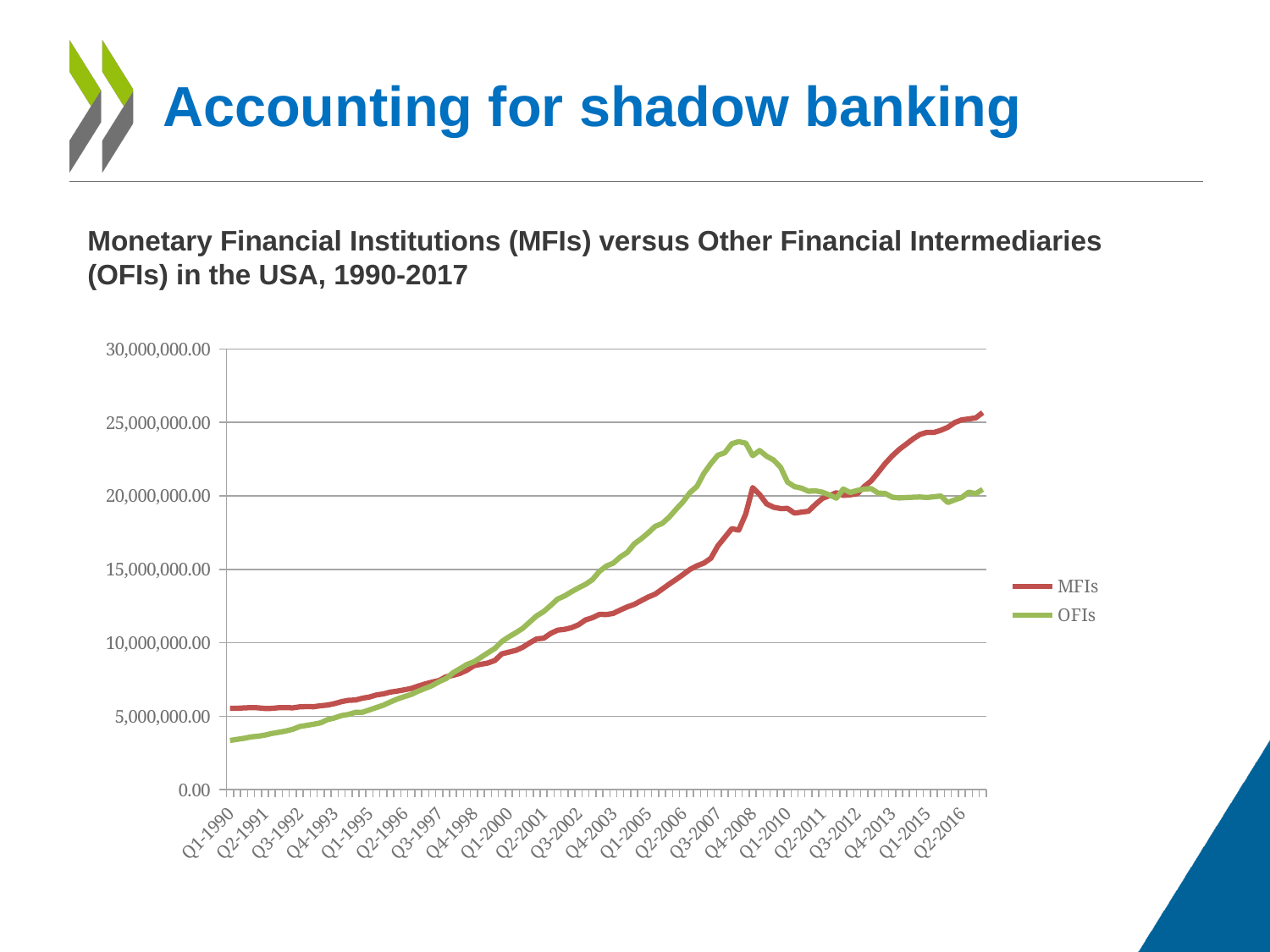
How many series does the legend list? 2 What are the two series named in the legend? MFIs and OFIs Around Q4-2008, which series has the higher value, MFIs or OFIs? OFIs Is the value for MFIs at Q3-2007 greater or less than 20,000,000.00? less Is the value for MFIs at Q1-1990 greater or less than 10,000,000.00? less Which colour is used for the OFIs line? Green Does the MFIs line overall rise or fall from Q1-1990 to the end of the series? Rise At Q1-1990, which series has the higher value, MFIs or OFIs? MFIs Is the value for OFIs at Q1-1990 greater or less than 5,000,000.00? less At Q2-2016, which series has the higher value, MFIs or OFIs? MFIs What kind of chart is shown on the slide? Line chart